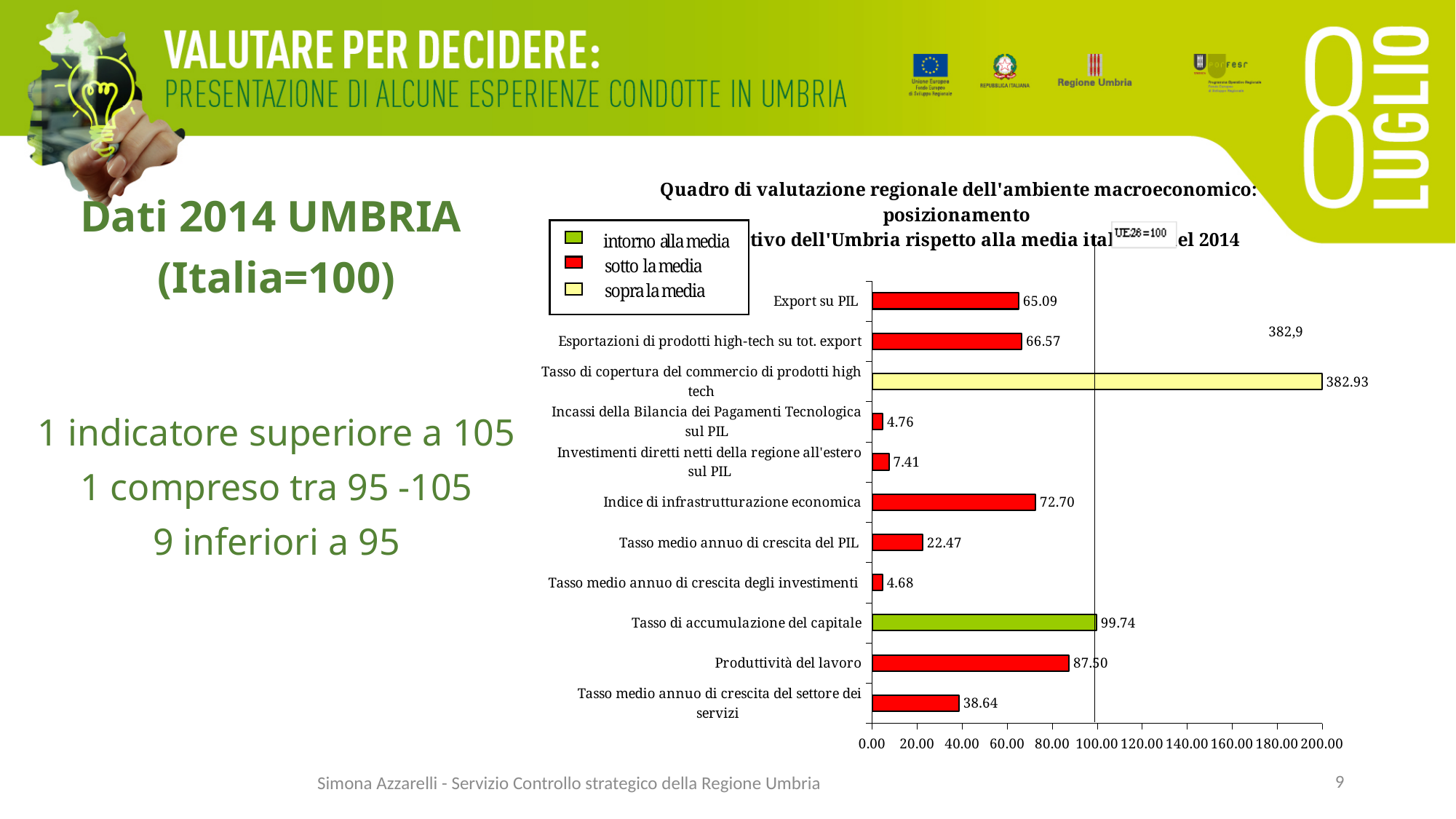
What is the value for Tasso medio annuo di crescita del PIL? 22.47 What kind of chart is shown on the slide? bar chart What is the value for Export su PIL? 65.09 Which indicator has the highest value? Tasso di copertura del commercio di prodotti high tech What is the value for Produttività del lavoro? 87.50 What is the difference between Indice di infrastrutturazione economica and Export su PIL? 7.61 How many indicators are plotted in the chart? 11 Is the value for Tasso medio annuo di crescita del settore dei servizi greater or less than 40.00? less What is the difference between Tasso di accumulazione del capitale and Produttività del lavoro? 12.24 What is the value for Tasso di accumulazione del capitale? 99.74 Which is larger: Produttività del lavoro or Indice di infrastrutturazione economica? Produttività del lavoro How many entries does the legend list? 3